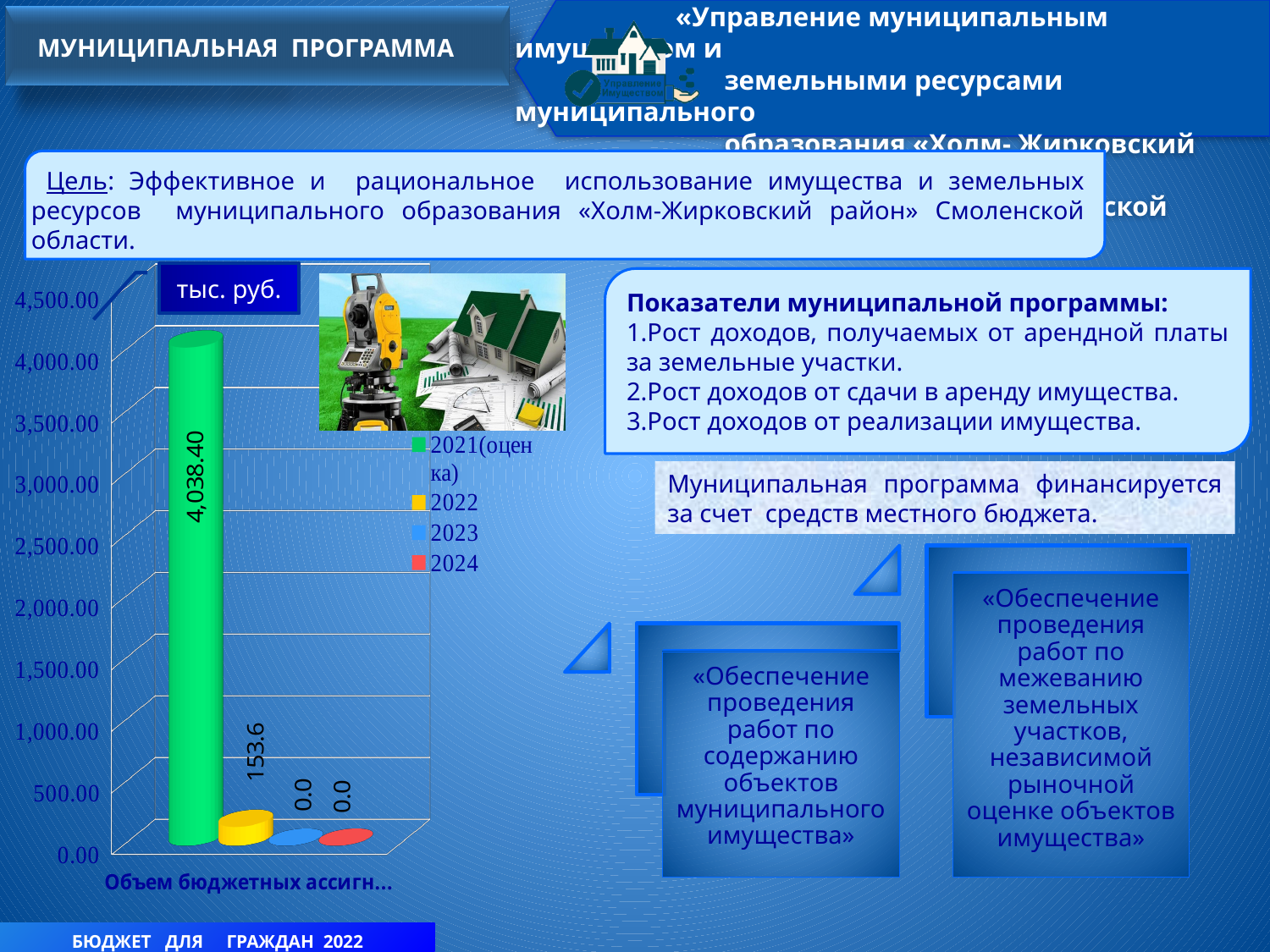
What is the value for the 2021(оценка) series on the chart? 4,038.40 How many series does the chart legend list? 4 Is the value for 2022 greater or less than 500.00? less What is the value for the 2023 series on the chart? 0.0 Is the value for 2021(оценка) greater or less than 4,000.00? greater What kind of chart is shown on the slide? bar chart What is the value for the 2022 series on the chart? 153.6 What unit is shown in the label above the chart's vertical axis? тыс. руб. Which is larger, the value for 2021(оценка) or the value for 2022? 2021(оценка) Which series has the highest value on the chart? 2021(оценка) What is the value for the 2024 series on the chart? 0.0 What is the difference between the 2021(оценка) value and the 2022 value? 3,884.80